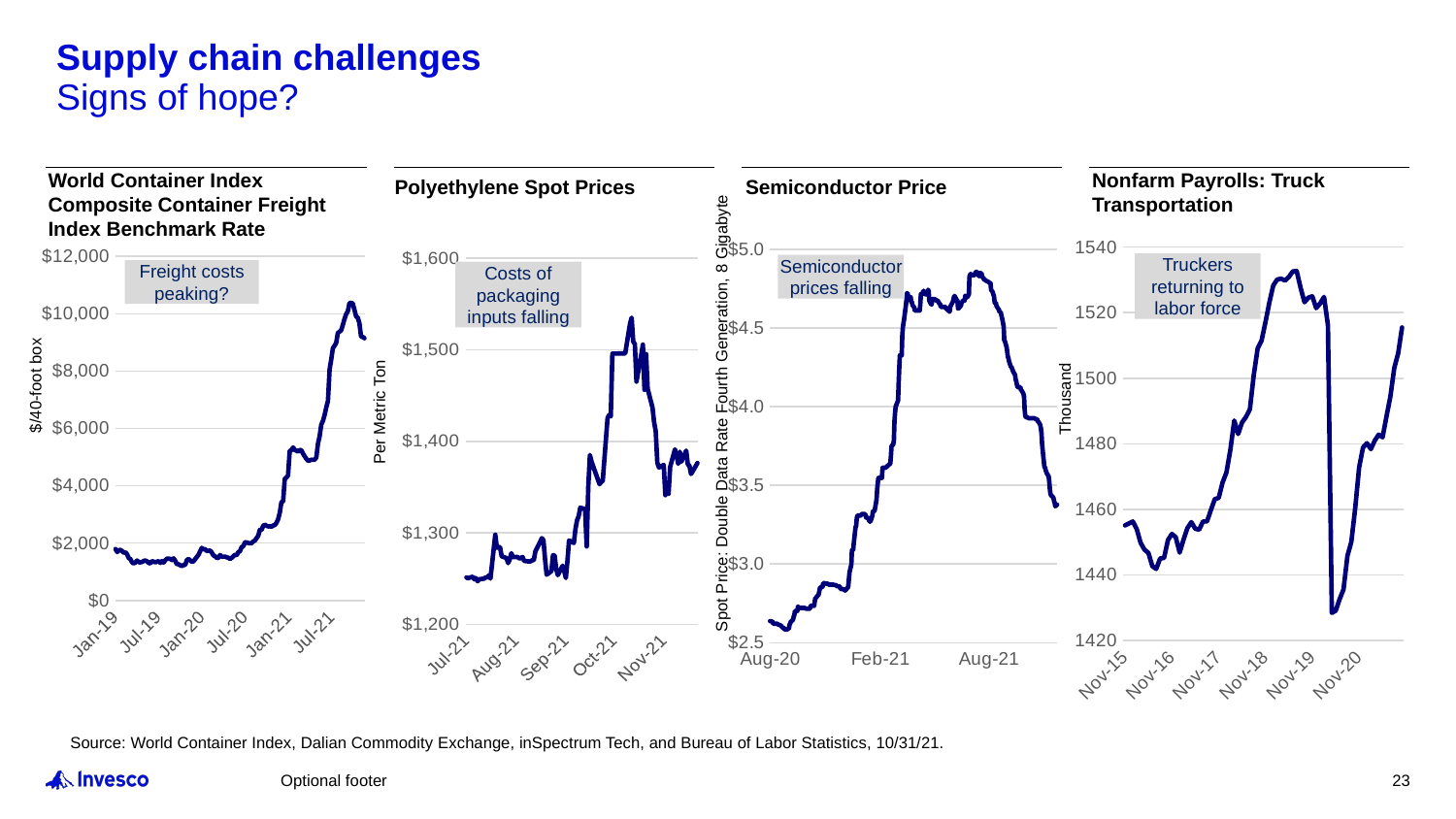
On the Semiconductor Price chart, does the price rise or fall between Aug-20 and Feb-21? rise On the World Container Index chart, is the last plotted value greater or less than $8,000? greater On the Nonfarm Payrolls: Truck Transportation chart, is the lowest plotted value greater or less than 1440? less On the Nonfarm Payrolls: Truck Transportation chart, is the value at Nov-15 greater or less than 1480? less What is the y-axis label on the World Container Index chart? $/40-foot box On the Nonfarm Payrolls: Truck Transportation chart, do values rise or fall between Nov-16 and Nov-18? rise What annotation text appears on the Nonfarm Payrolls: Truck Transportation chart? Truckers returning to labor force What kind of chart is the World Container Index chart? line chart